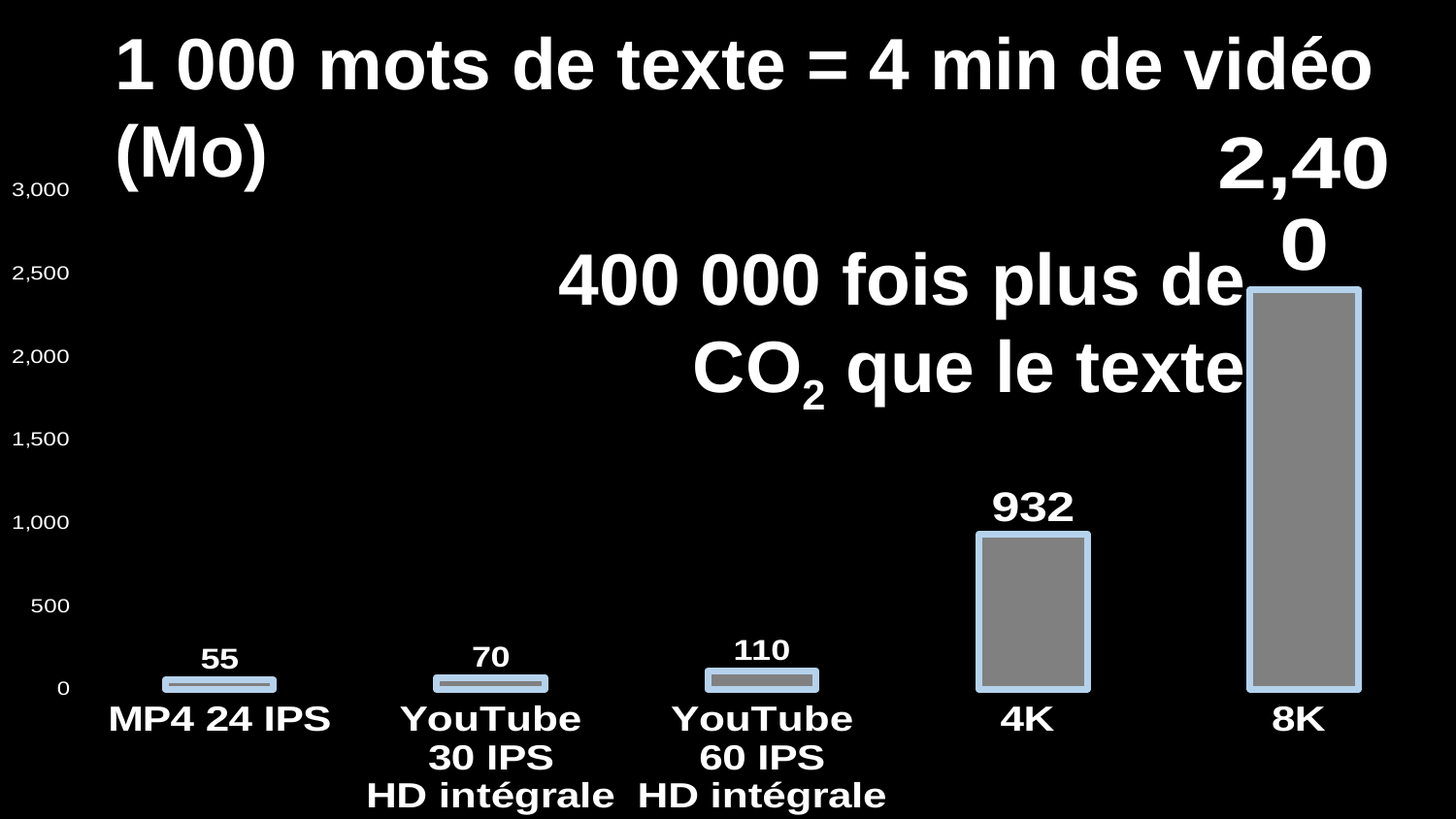
Which category has the lowest value? MP4 24 IPS What is the difference between the values for 8K and 4K? 1,468 What is the value for 4K? 932 What is the value for MP4 24 IPS? 55 Is the value for 4K greater or less than 1,000? less Which category has the highest value? 8K What is the value for YouTube 60 IPS HD intégrale? 110 What is the difference between the values for YouTube 60 IPS HD intégrale and YouTube 30 IPS HD intégrale? 40 What is the value for 8K? 2,400 Which is larger, the value for 4K or the value for YouTube 30 IPS HD intégrale? 4K What kind of chart is shown on the slide? bar chart How many categories are shown on the x axis? 5